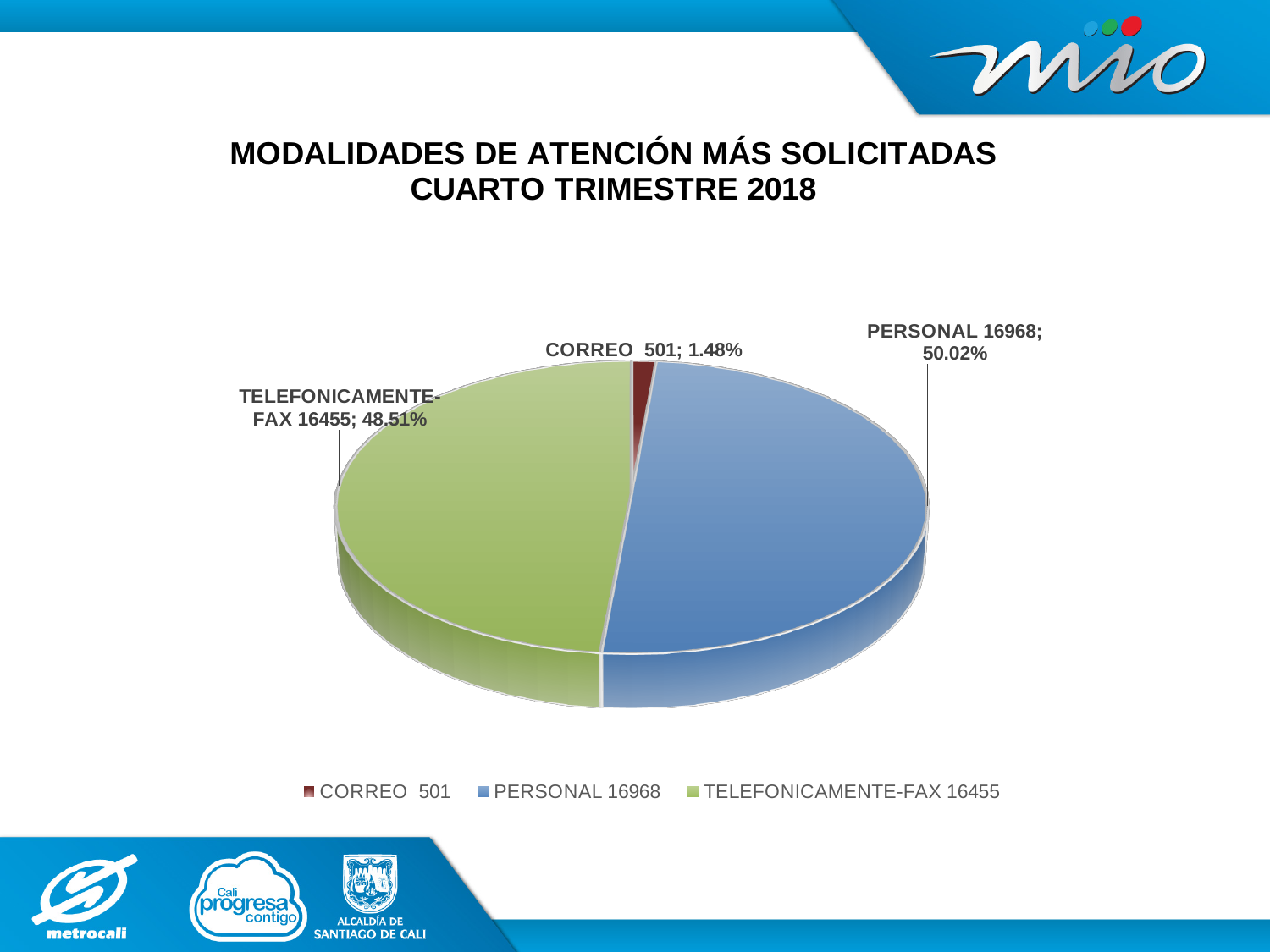
What is the value for CORREO? 501 What share of the pie does PERSONAL represent? 50.02% What is the value for PERSONAL? 16968 How many slices does the pie chart have? 3 What is the value for TELEFONICAMENTE-FAX? 16455 Which category has the smallest slice? CORREO What is the difference between the values for PERSONAL and TELEFONICAMENTE-FAX? 513 What share of the pie does CORREO represent? 1.48% What kind of chart is shown on the slide? pie chart Which category has the largest slice? PERSONAL What is the title of the chart? MODALIDADES DE ATENCIÓN MÁS SOLICITADAS CUARTO TRIMESTRE 2018 What share of the pie does TELEFONICAMENTE-FAX represent? 48.51%